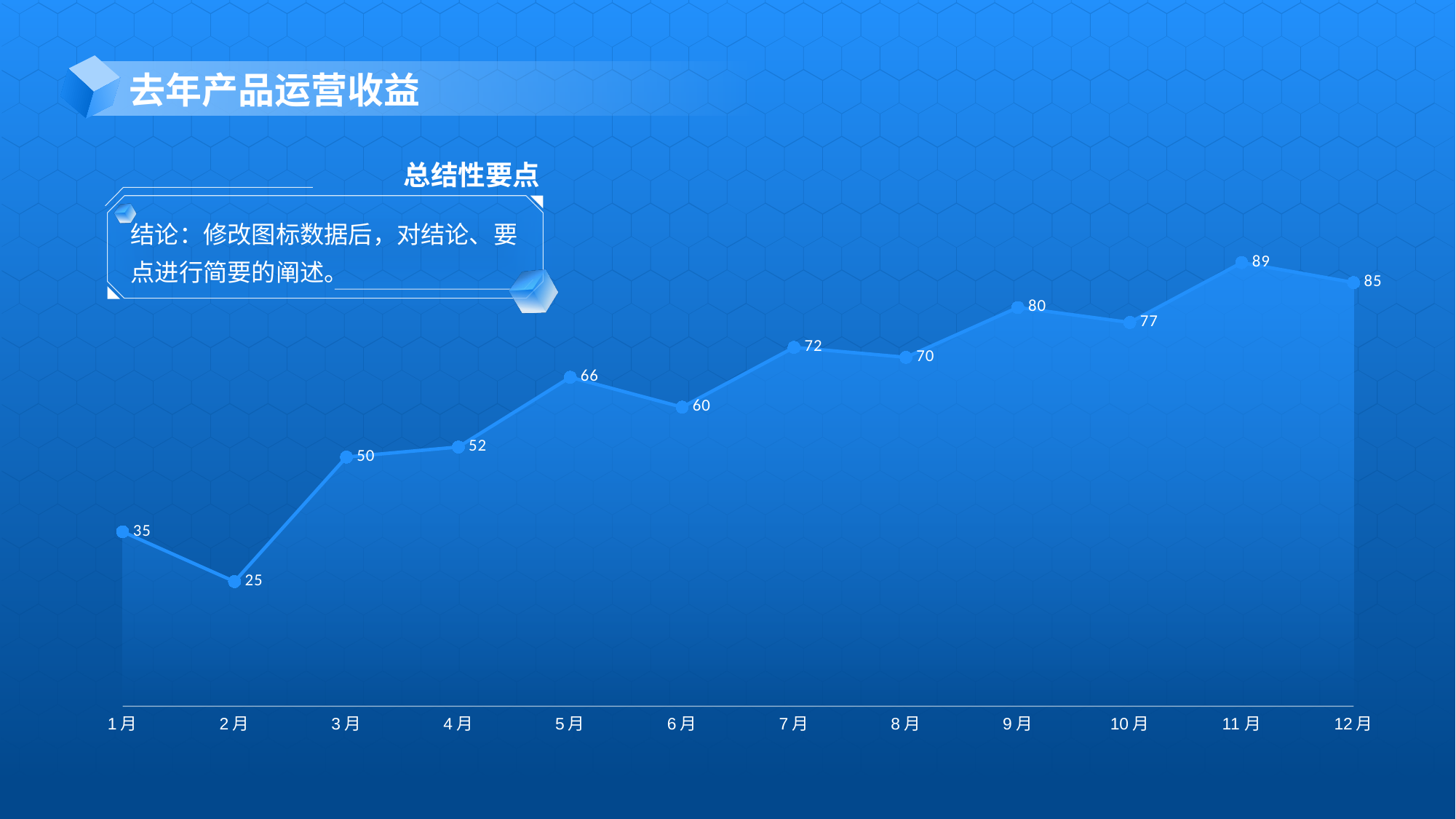
What is the title of the slide containing the chart? 去年产品运营收益 What is the value for 1月? 35 Do the values generally rise or fall from 1月 to 12月? rise What is the difference between the values for 12月 and 1月? 50 Which month has the lowest value? 2月 What kind of chart is shown on the slide? line chart What is the value for 5月? 66 Which month has the highest value? 11月 Which is larger, the value for 6月 or the value for 7月? 7月 What is the difference between the values for 9月 and 8月? 10 What is the value for 10月? 77 How many months are plotted on the x axis? 12